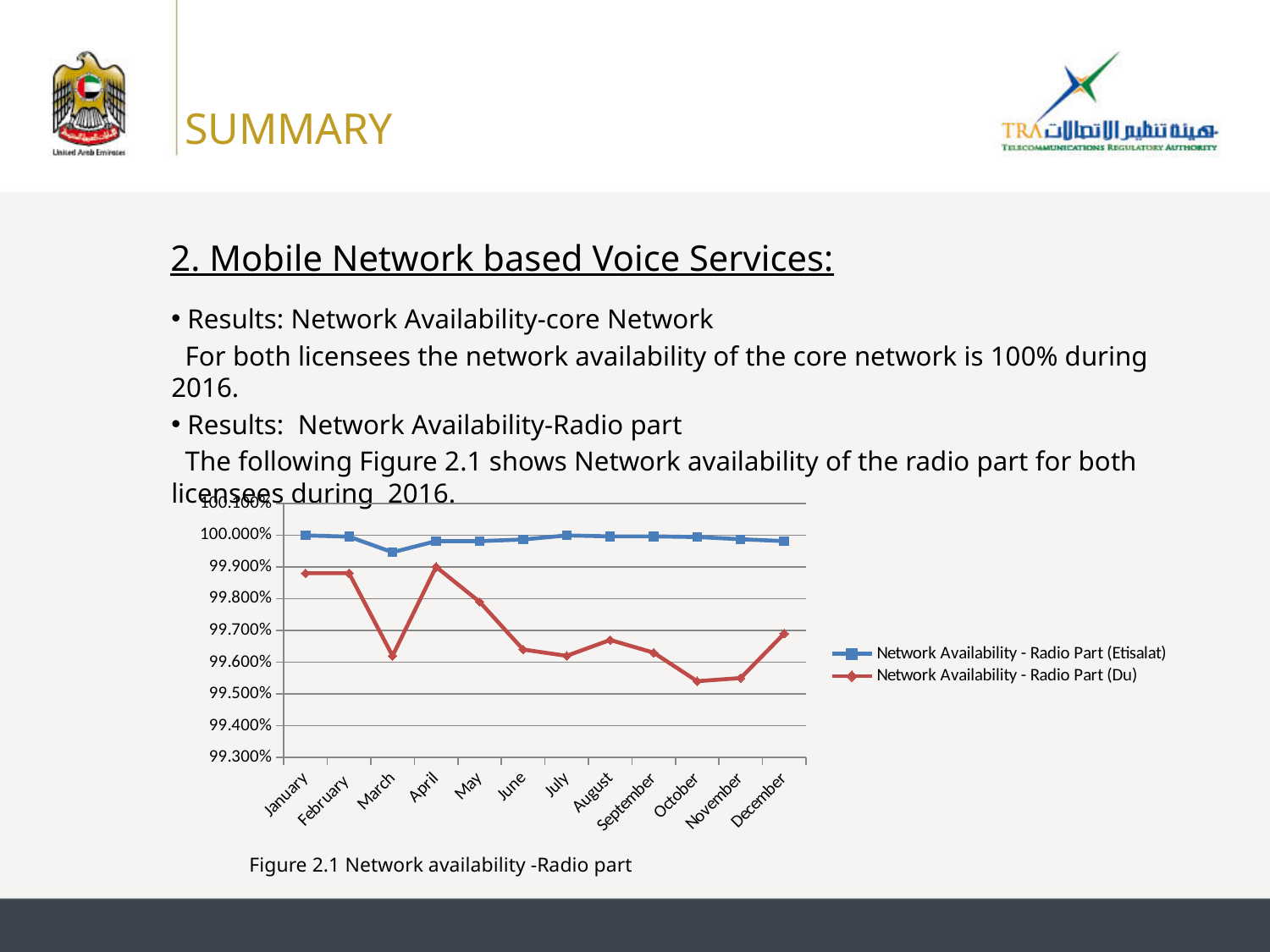
Is the value for Etisalat in March greater or less than 99.900%? greater What kind of chart is shown on the slide? line chart Does the Du series rise or fall from April to July? fall How many months are plotted along the x axis of the chart? 12 Which series does the red line with diamond markers represent? Network Availability - Radio Part (Du) Is the value for Du in October greater or less than 99.600%? less What is the caption given below the chart? Figure 2.1 Network availability -Radio part Is the value for Du in March greater or less than 99.700%? less In which month is the Etisalat series at its lowest? March How many series does the chart legend list? 2 Which series has the higher value in January, Etisalat or Du? Etisalat